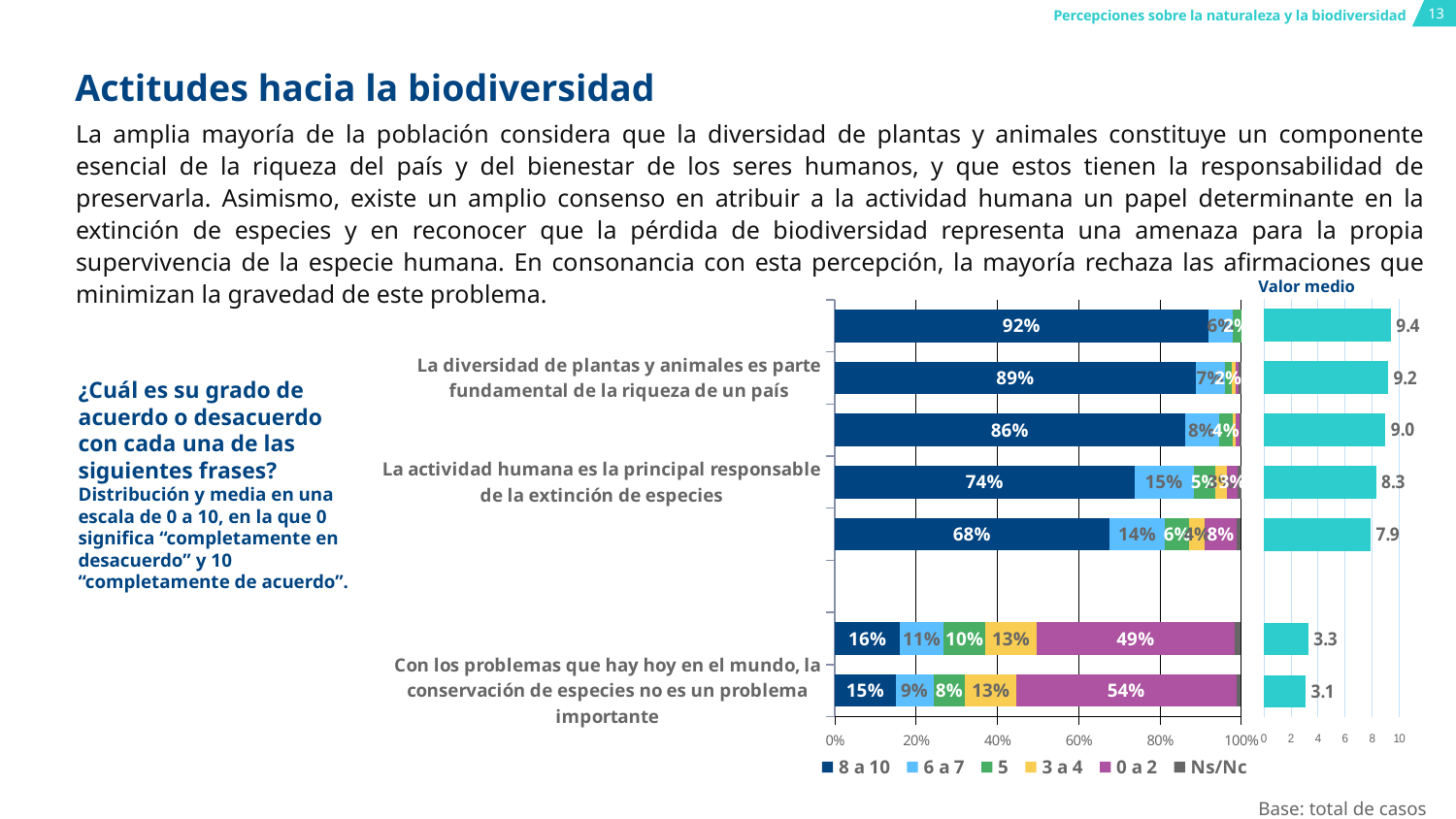
In the 'Valor medio' chart, what is the mean value for 'Con los problemas que hay hoy en el mundo, la conservación de especies no es un problema importante'? 3.1 In the stacked bar chart, what percentage gave '8 a 10' for 'Con los problemas que hay hoy en el mundo, la conservación de especies no es un problema importante'? 15% How many bars (statements) are plotted in the stacked bar chart? 7 What is the highest value shown in the 'Valor medio' chart? 9.4 What kind of chart is the main chart on the slide showing the distribution of agreement? Bar chart In the stacked bar chart, what percentage gave '0 a 2' for 'Con los problemas que hay hoy en el mundo, la conservación de especies no es un problema importante'? 54% In the stacked bar chart, what percentage gave '6 a 7' for 'La actividad humana es la principal responsable de la extinción de especies'? 15% In the stacked bar chart, what percentage gave '8 a 10' for 'La diversidad de plantas y animales es parte fundamental de la riqueza de un país'? 89% In the stacked bar chart, what is the difference in the '8 a 10' percentage between 'La diversidad de plantas y animales es parte fundamental de la riqueza de un país' and 'La actividad humana es la principal responsable de la extinción de especies'? 15 percentage points In the stacked bar chart, what percentage gave '8 a 10' for 'La actividad humana es la principal responsable de la extinción de especies'? 74% In the 'Valor medio' chart, what is the mean value for 'La actividad humana es la principal responsable de la extinción de especies'? 8.3 How many series does the legend of the stacked bar chart list? 6